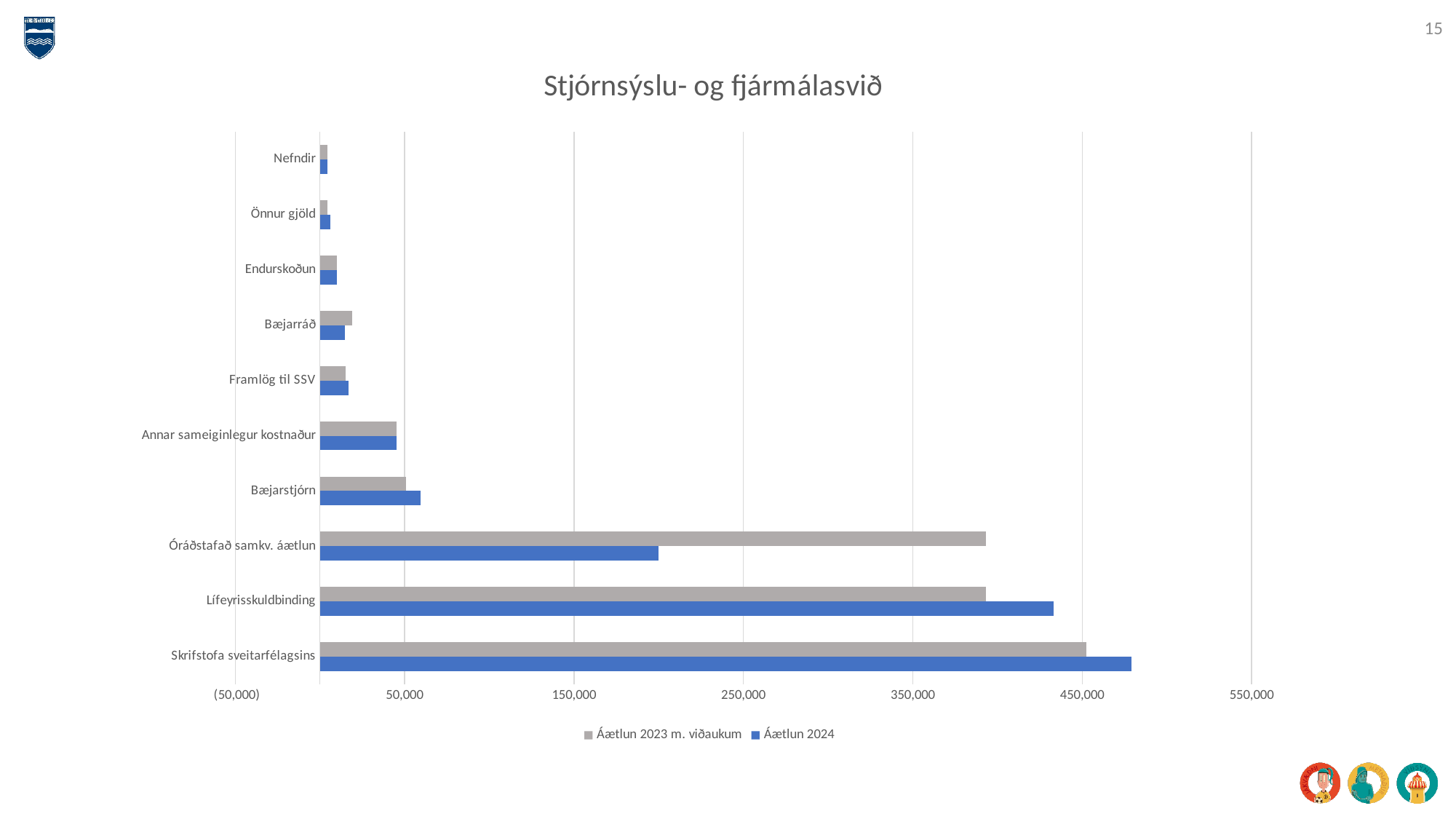
Which category has the highest value for Áætlun 2024? Skrifstofa sveitarfélagsins Is the Áætlun 2024 value for Óráðstafað samkv. áætlun greater or less than 250,000? less How many categories are shown on the chart? 10 Is the Áætlun 2023 m. viðaukum value for Óráðstafað samkv. áætlun greater or less than 350,000? greater Which category has the highest value for Áætlun 2023 m. viðaukum? Skrifstofa sveitarfélagsins For Lífeyrisskuldbinding, which series has the larger value: Áætlun 2023 m. viðaukum or Áætlun 2024? Áætlun 2024 For Óráðstafað samkv. áætlun, which series has the larger value: Áætlun 2023 m. viðaukum or Áætlun 2024? Áætlun 2023 m. viðaukum How many series does the legend list? 2 Is the Áætlun 2024 value for Skrifstofa sveitarfélagsins greater or less than 450,000? greater Which category has the lowest value for Áætlun 2024? Nefndir What is the title of the chart? Stjórnsýslu- og fjármálasvið What kind of chart is shown on the slide? bar chart